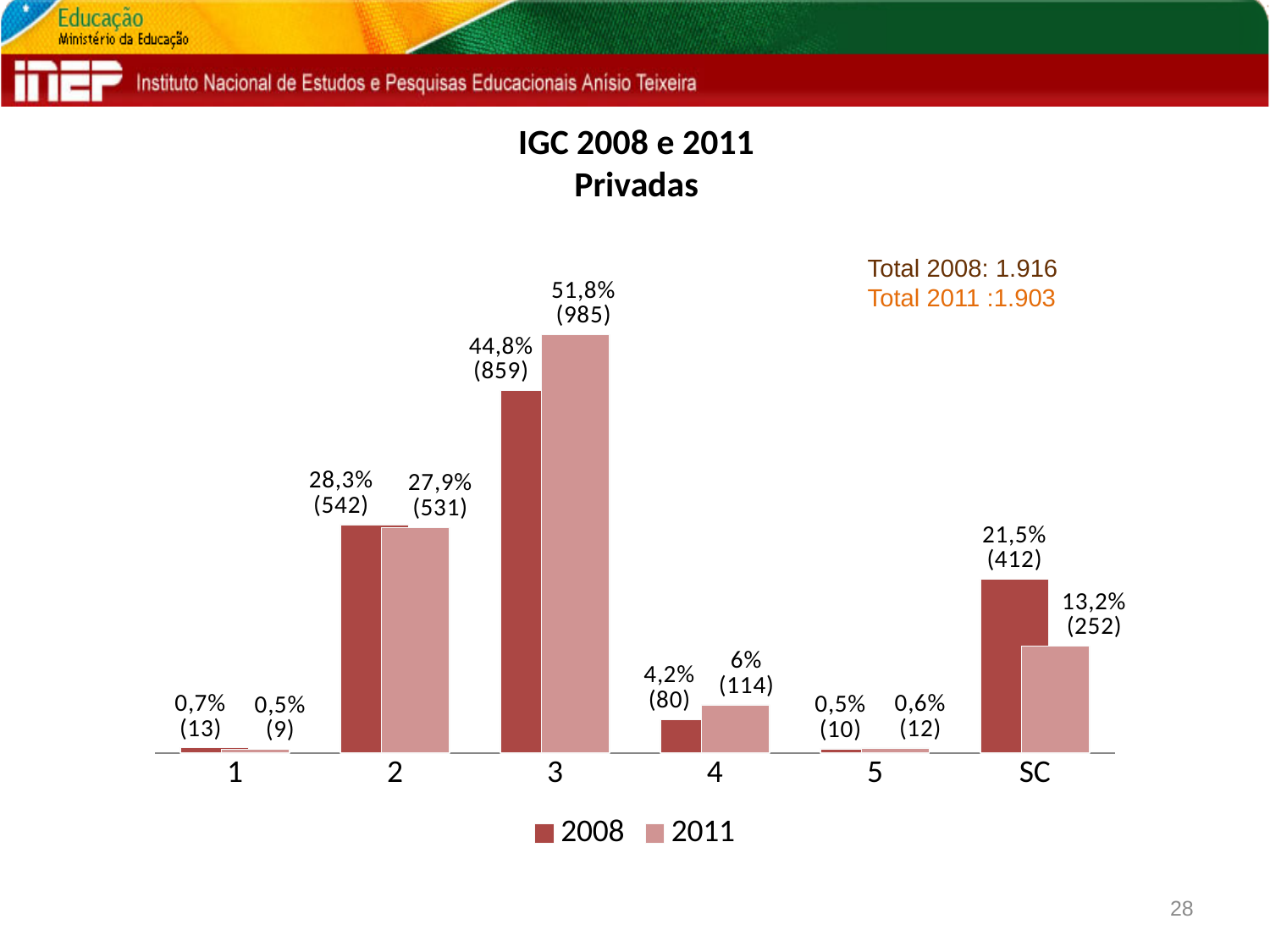
What is the total for 2008 stated on the slide? 1.916 Which category has the highest value for 2008? 3 How many series does the legend list? 2 What kind of chart is shown on the slide? bar chart What is the count shown for category 2 in 2008? 542 What is the percentage for SC in 2011? 13,2% How many categories are shown on the x axis? 6 Which category has the lowest value for 2011? 1 What is the percentage for category 3 in 2011? 51,8% What is the difference in count between 2008 and 2011 for SC? 160 Which is larger for category 4: the 2008 value or the 2011 value? 2011 What is the title of the chart? IGC 2008 e 2011 Privadas